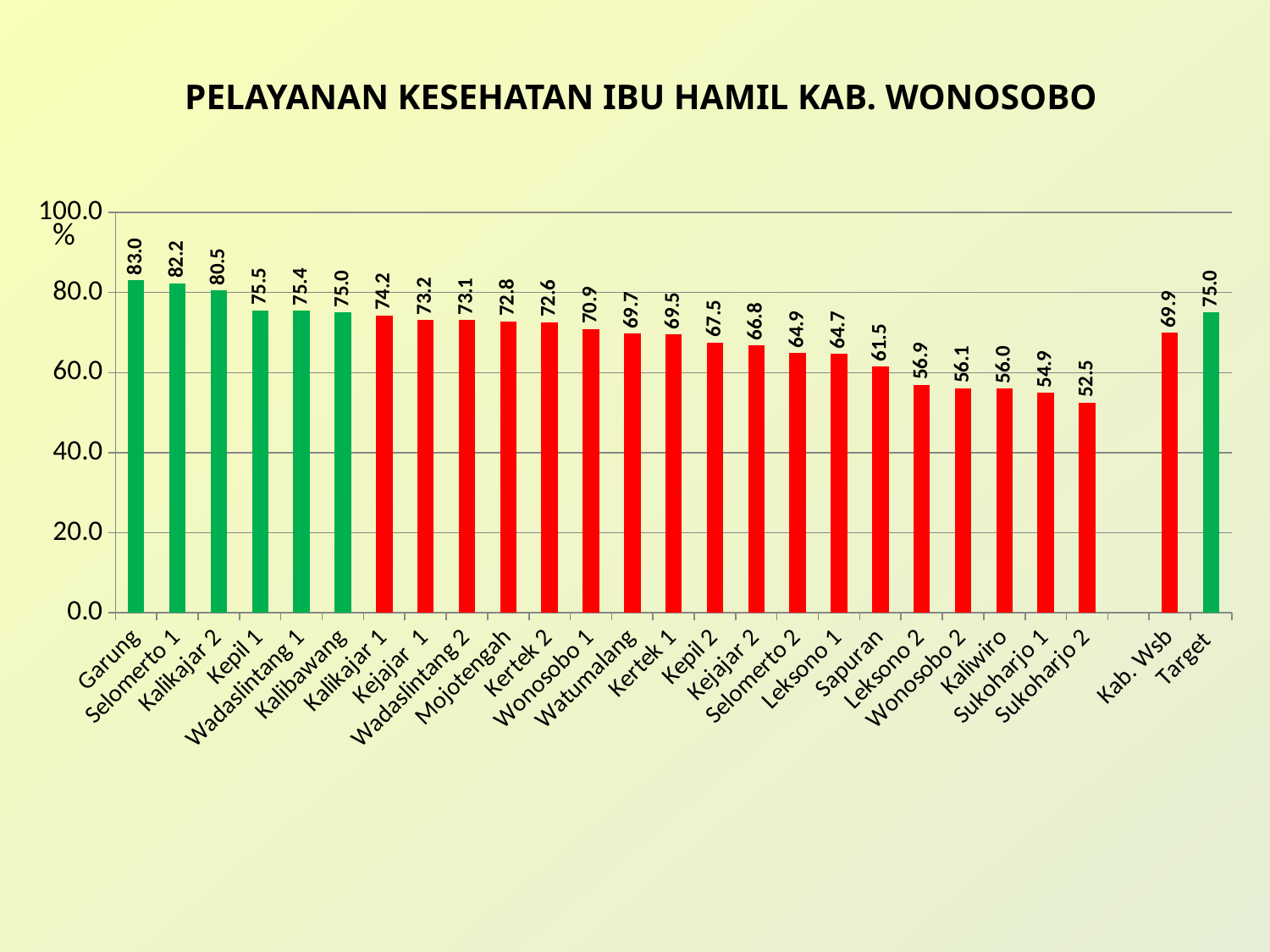
What kind of chart is shown on the slide? Bar chart What is the value shown for Target? 75.0 What is the title of the chart? PELAYANAN KESEHATAN IBU HAMIL KAB. WONOSOBO What is the value for Garung? 83.0 What is the difference between the Target value and the Kab. Wsb value? 5.1 What is the value for Kab. Wsb? 69.9 Which is larger, the value for Kertek 2 or the value for Kertek 1? Kertek 2 Which category has the lowest value? Sukoharjo 2 How many bars are plotted in the chart? 26 Which category has the highest value? Garung What is the value for Sapuran? 61.5 What is the difference between the values for Garung and Sukoharjo 2? 30.5